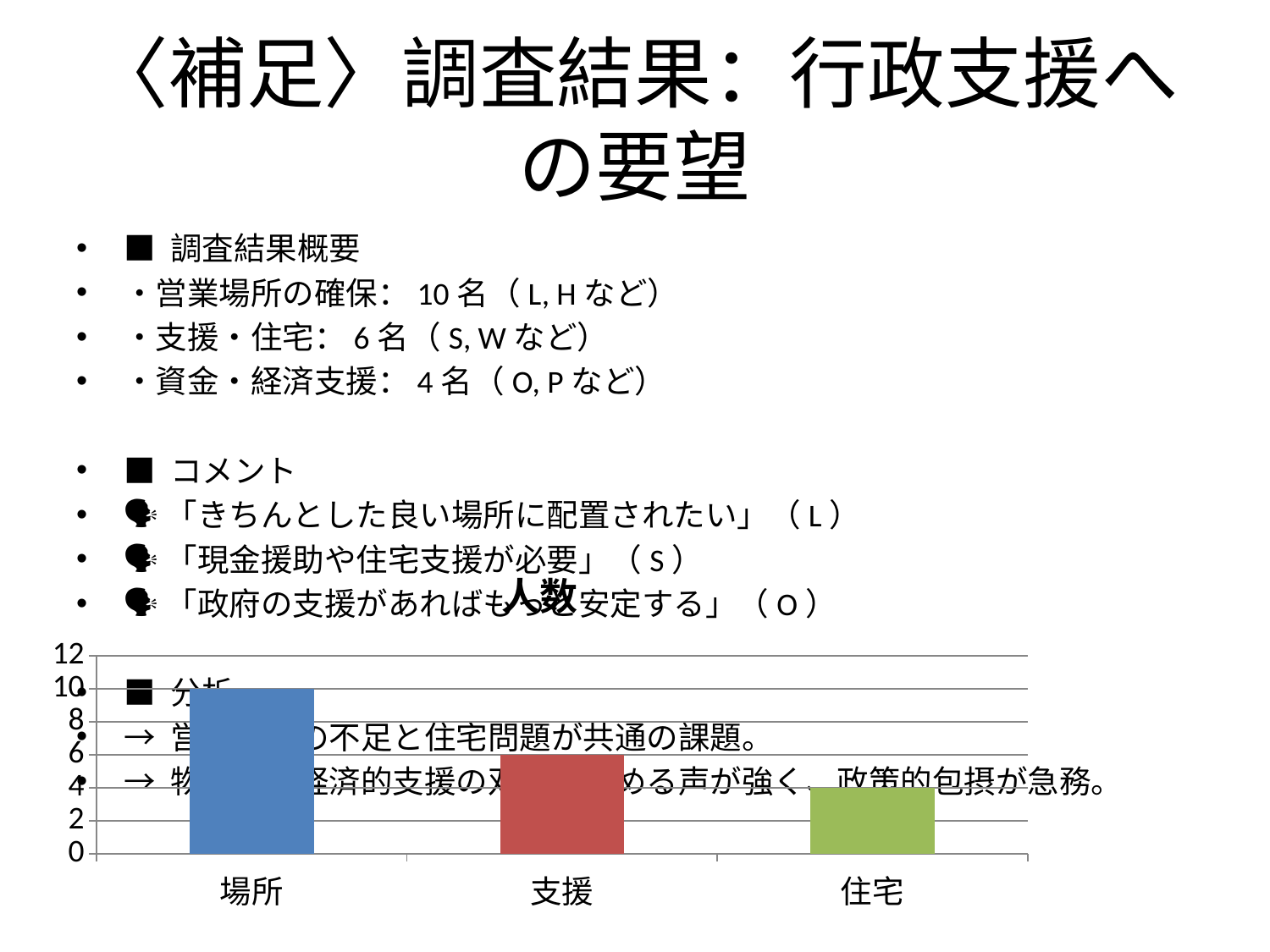
What is the title of the chart? 人数 How many categories are shown on the x axis of the chart? 3 What is the value for 支援 in the chart? 6 Which category has the highest value in the chart? 場所 What is the value for 場所 in the chart? 10 Do the values rise or fall from left to right along the x axis? fall What type of chart is shown on the slide? bar chart Which category has the lowest value in the chart? 住宅 What is the value for 住宅 in the chart? 4 What is the difference between the values for 支援 and 住宅? 2 What is the difference between the values for 場所 and 住宅? 6 Which is larger, the value for 支援 or the value for 住宅? 支援